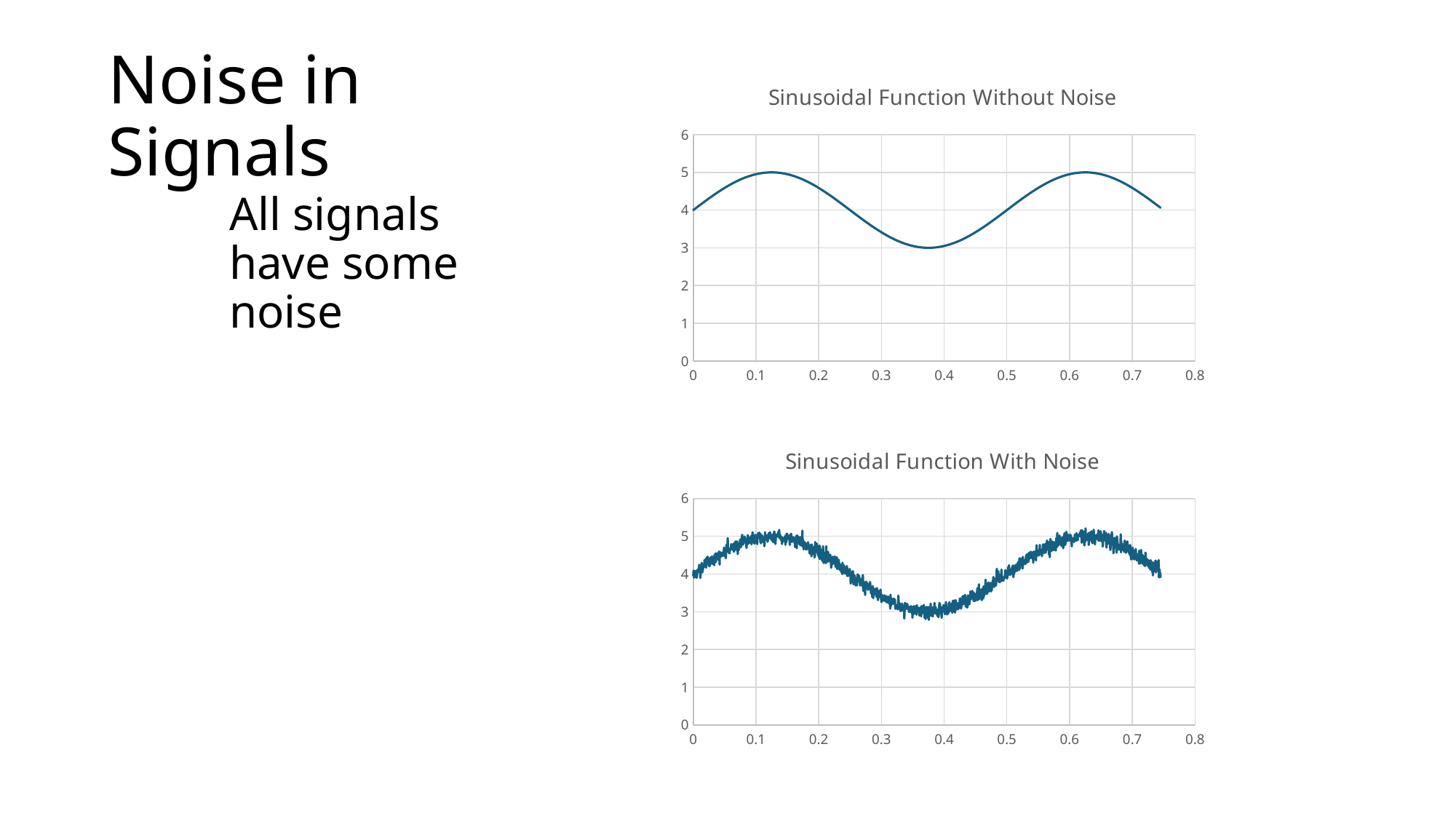
What kind of chart is the 'Sinusoidal Function With Noise' chart? line chart In the 'Sinusoidal Function Without Noise' chart, which is larger: the value at x = 0.1 or the value at x = 0.4? the value at x = 0.1 In the 'Sinusoidal Function Without Noise' chart, does the curve rise or fall between x = 0.2 and x = 0.3? fall In the 'Sinusoidal Function With Noise' chart, is the value near x = 0.4 greater or less than 4? less What is the title of the top chart on the slide? Sinusoidal Function Without Noise In the 'Sinusoidal Function With Noise' chart, does the signal rise or fall between x = 0.4 and x = 0.6? rise In the 'Sinusoidal Function Without Noise' chart, what is the value of the curve at x = 0? 4 What kind of chart is the 'Sinusoidal Function Without Noise' chart? line chart In the 'Sinusoidal Function Without Noise' chart, is the value at x = 0.2 greater or less than 3? greater In the 'Sinusoidal Function Without Noise' chart, what is the maximum value the curve reaches? 5 What is the title of the bottom chart on the slide? Sinusoidal Function With Noise In the 'Sinusoidal Function Without Noise' chart, what is the minimum value the curve reaches? 3